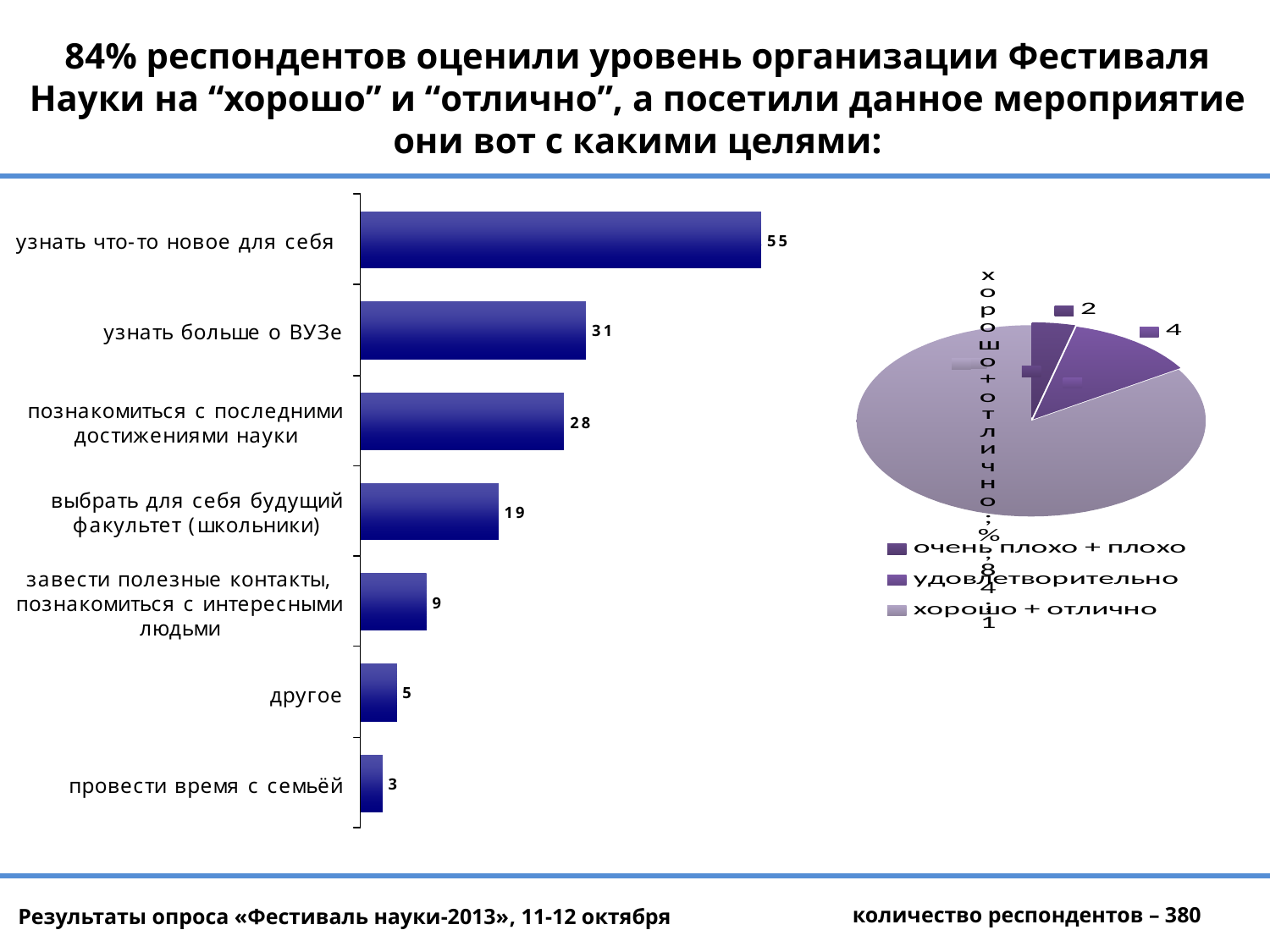
In the bar chart on the left, what is the value for "узнать что-то новое для себя"? 55 How many categories does the bar chart on the left show? 7 In the bar chart on the left, which category has the highest value? узнать что-то новое для себя In the bar chart on the left, what is the value for "другое"? 5 How many entries does the legend of the pie chart on the right list? 3 What kind of chart is the chart on the right of the slide? pie chart What kind of chart is the chart on the left of the slide? bar chart In the bar chart on the left, which category has the lowest value? провести время с семьёй In the bar chart on the left, what is the value for "выбрать для себя будущий факультет (школьники)"? 19 In the bar chart on the left, which is larger: the value for "завести полезные контакты, познакомиться с интересными людьми" or the value for "другое"? завести полезные контакты, познакомиться с интересными людьми In the bar chart on the left, what is the difference between the values for "узнать больше о ВУЗе" and "познакомиться с последними достижениями науки"? 3